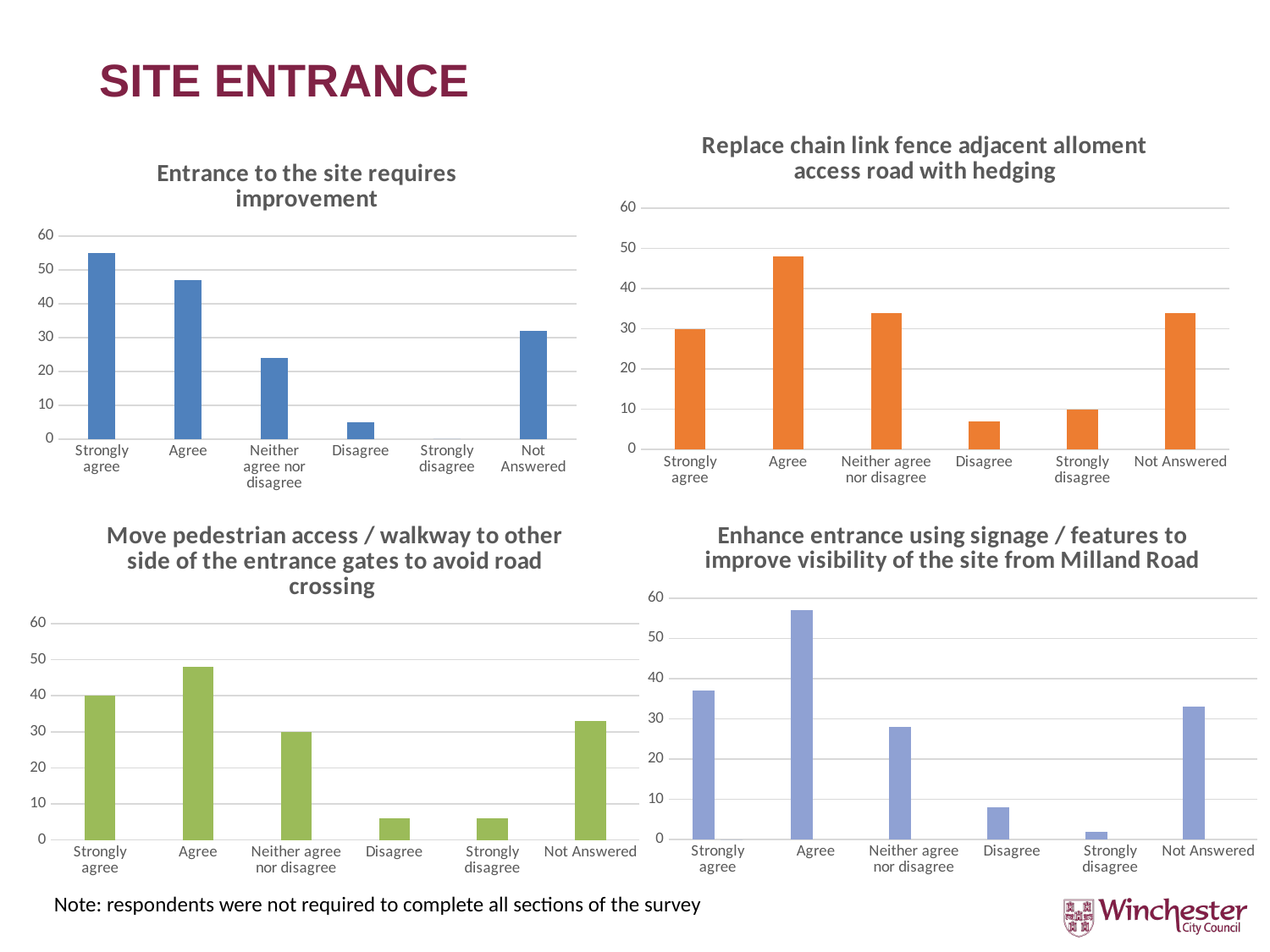
In the chart titled 'Entrance to the site requires improvement', is the value for Disagree greater or less than 10? less What type of chart is the chart titled 'Entrance to the site requires improvement'? Bar chart In the chart titled 'Replace chain link fence adjacent alloment access road with hedging', which category has the highest value? Agree In the chart titled 'Move pedestrian access / walkway to other side of the entrance gates to avoid road crossing', which is larger, Agree or Not Answered? Agree In the chart titled 'Entrance to the site requires improvement', is the value for Agree greater or less than 40? greater In the chart titled 'Replace chain link fence adjacent alloment access road with hedging', which category has the lowest value? Disagree In the chart titled 'Enhance entrance using signage / features to improve visibility of the site from Milland Road', is the value for Agree greater or less than 50? greater How many categories are shown on the x axis of the chart titled 'Enhance entrance using signage / features to improve visibility of the site from Milland Road'? 6 In the chart titled 'Enhance entrance using signage / features to improve visibility of the site from Milland Road', which category has the lowest value? Strongly disagree In the chart titled 'Entrance to the site requires improvement', which category has the highest value? Strongly agree In the chart titled 'Move pedestrian access / walkway to other side of the entrance gates to avoid road crossing', what is the value for Strongly agree? 40